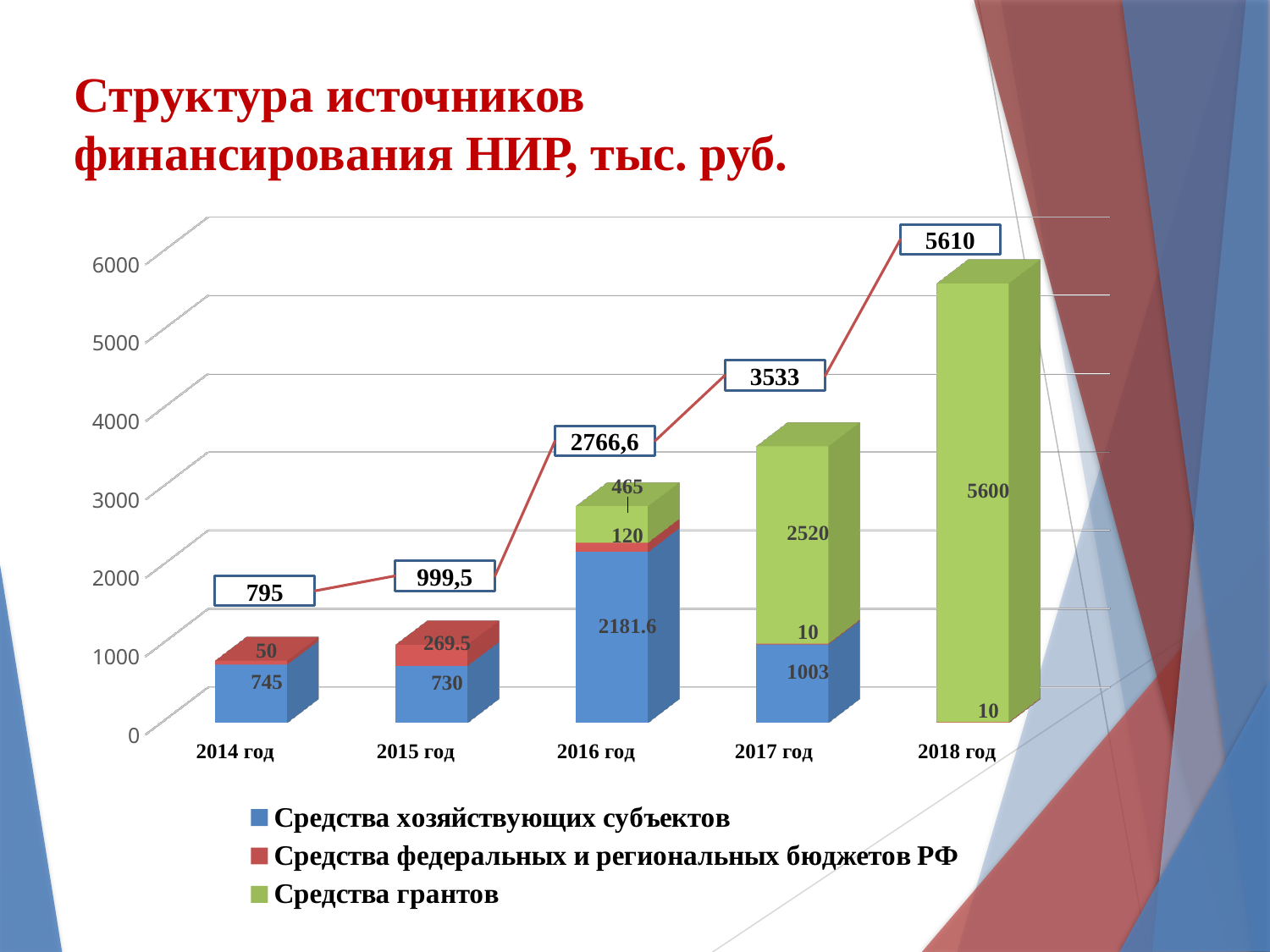
Which year has the highest total? 2018 год What total is labelled for 2018 год? 5610 What is the value of Средства федеральных и региональных бюджетов РФ for 2015 год? 269.5 What is the difference between the Средства грантов values for 2018 год and 2017 год? 3080 What type of chart is shown on the slide? stacked bar chart What total is labelled for 2015 год? 999,5 What is the value of Средства хозяйствующих субъектов for 2016 год? 2181.6 How many years are shown on the x axis? 5 How many series does the legend list? 3 Which year has the lowest total? 2014 год What is the value of Средства грантов for 2017 год? 2520 Do the labelled totals rise or fall from 2014 год to 2018 год? rise